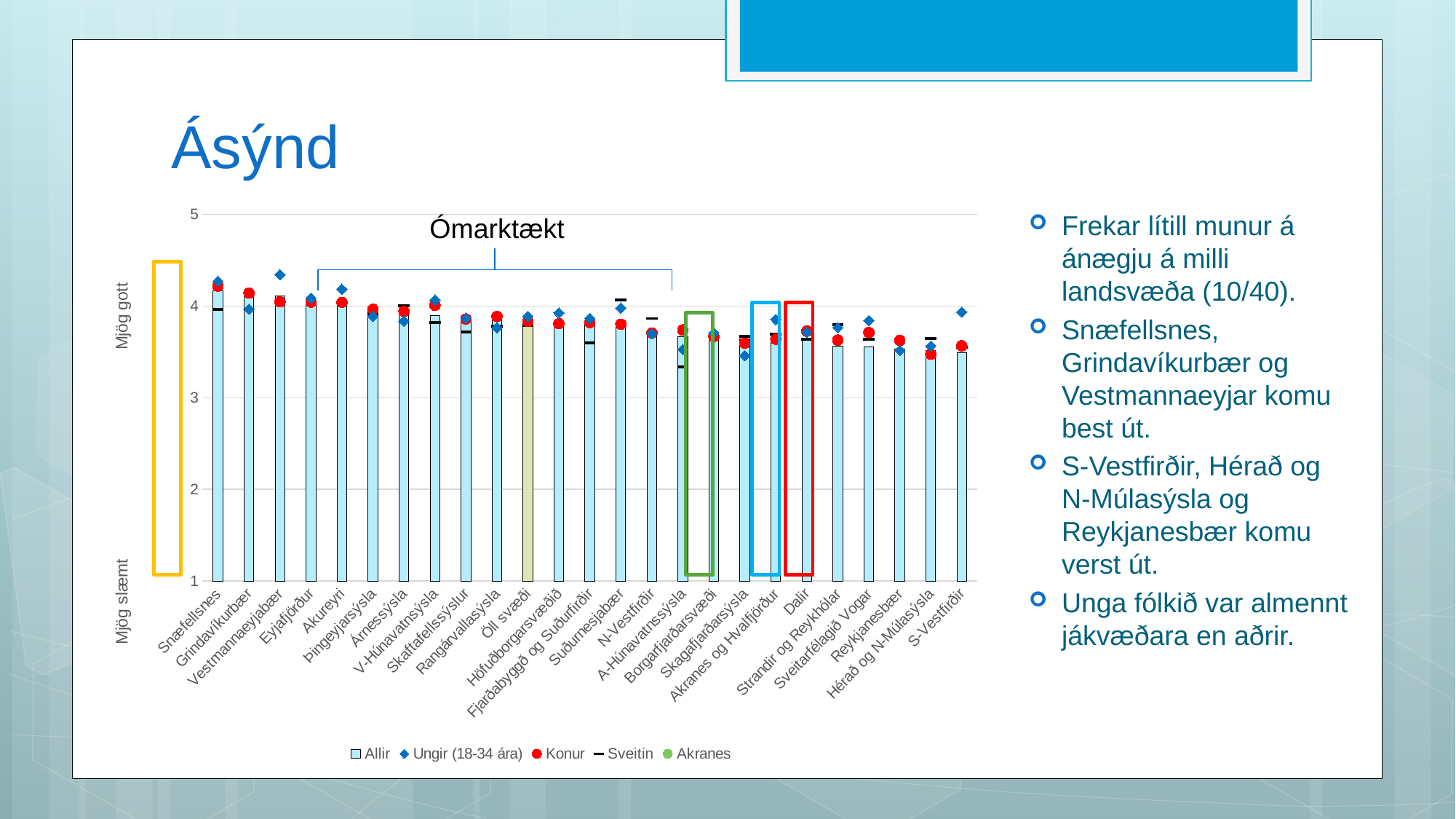
How many regions (categories) are shown along the x axis of the chart? 25 Which region has the highest 'Allir' bar in the chart? Snæfellsnes Is the 'Allir' bar for Snæfellsnes greater or less than 4? greater Which has the larger 'Allir' bar, Snæfellsnes or S-Vestfirðir? Snæfellsnes How many series does the chart legend list? 5 What kind of chart is shown on the slide? bar chart Do the 'Allir' bars generally rise or fall from left to right along the x axis? fall What label is written at the top of the y axis of the chart? Mjög gott Is the 'Allir' bar for S-Vestfirðir greater or less than 4? less Is the 'Allir' bar for A-Húnavatnssýsla greater or less than 4? less